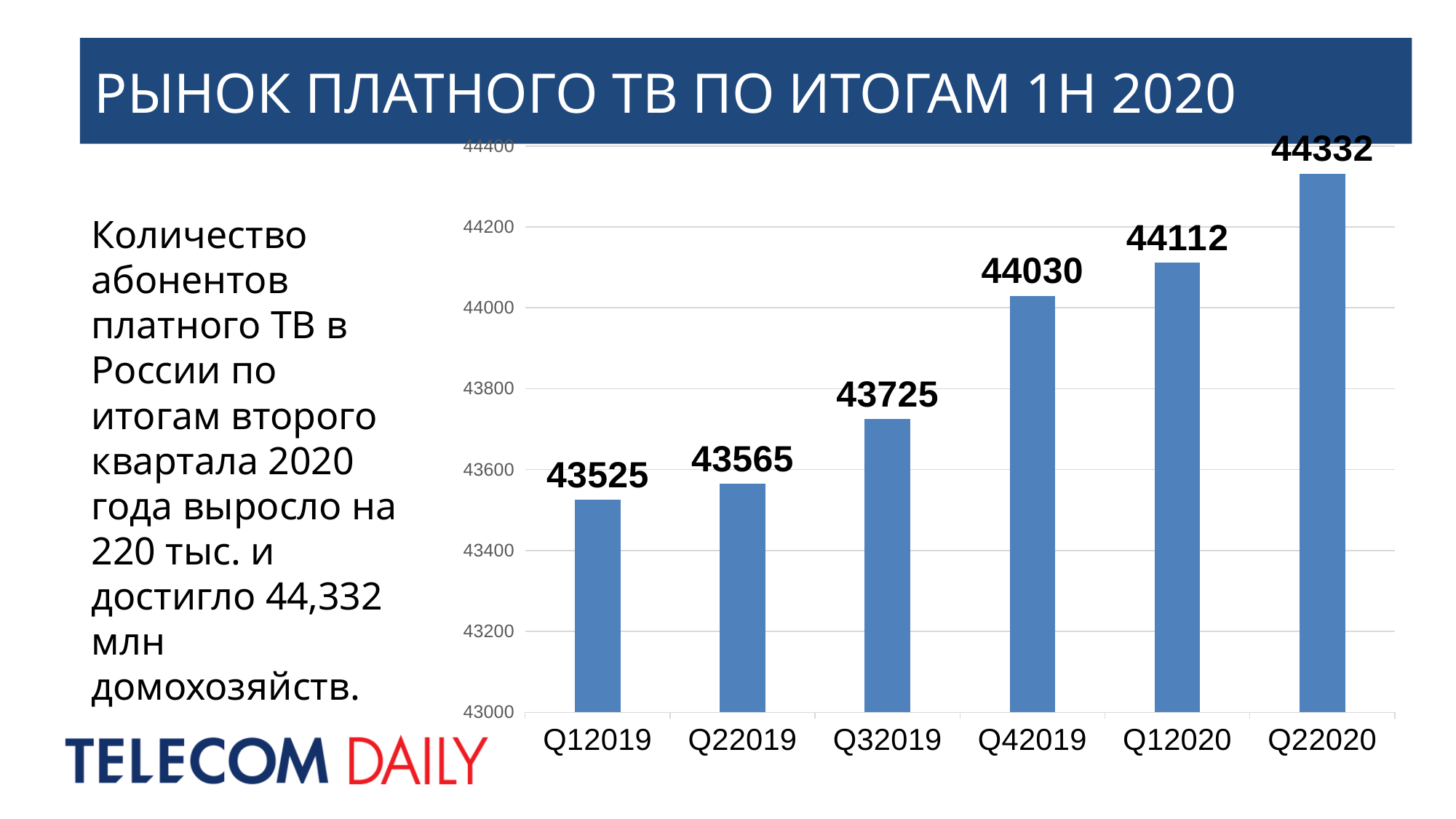
Which quarter has the highest value? Q22020 Do the values rise or fall from Q12019 to Q22020? rise How many quarters are shown on the x axis? 6 What is the value for Q22020? 44332 Which is larger, the value for Q22019 or the value for Q42019? Q42019 What is the value for Q32019? 43725 Which quarter has the lowest value? Q12019 Is the value for Q12020 greater or less than 44000? greater What is the value for Q12019? 43525 What is the difference between the values for Q22020 and Q12020? 220 What is the difference between the values for Q42019 and Q32019? 305 What kind of chart is shown on the slide? bar chart